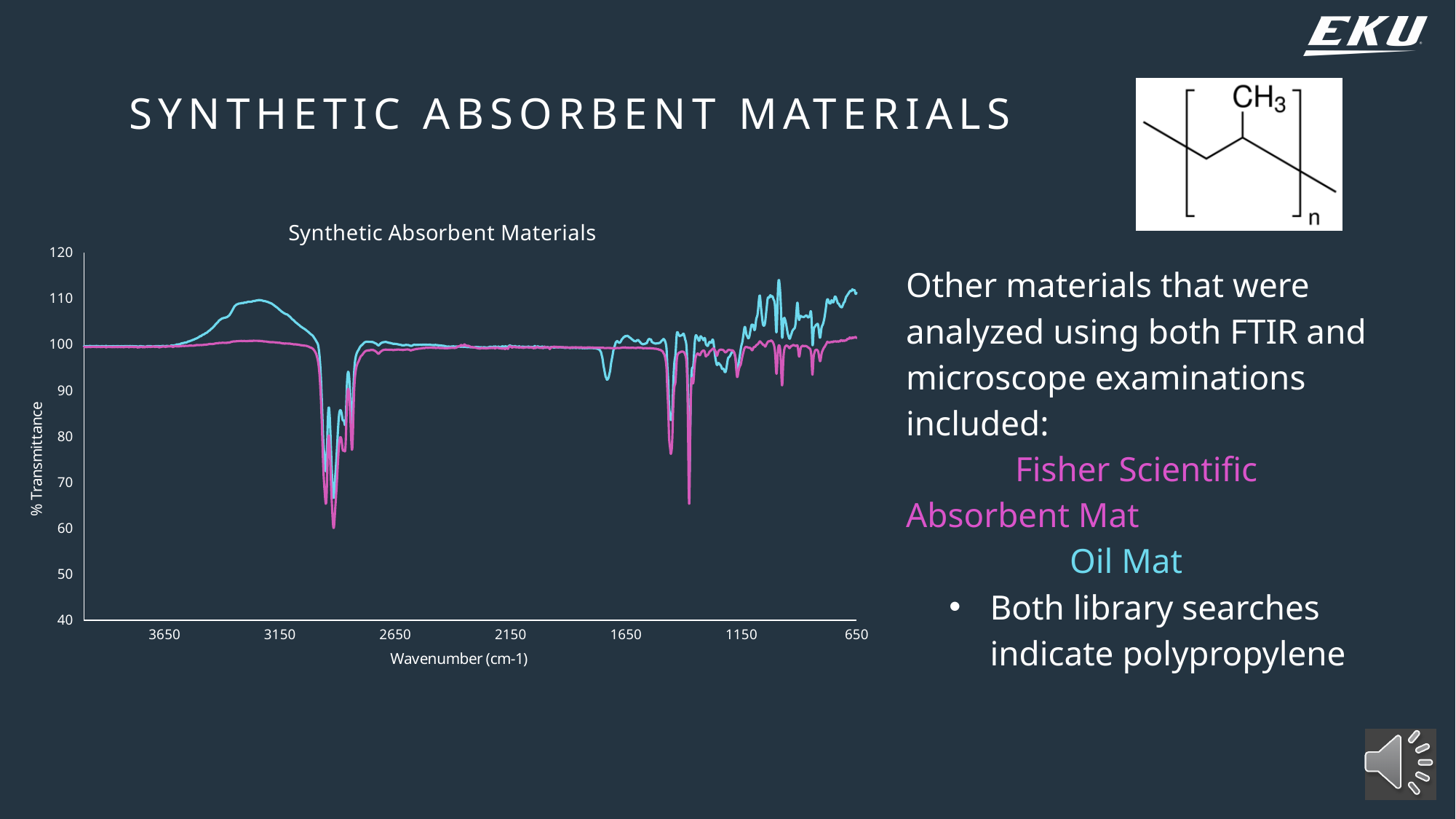
What is the title of the chart? Synthetic Absorbent Materials What kind of chart is shown on the slide? line chart What is the label on the y axis of the chart? % Transmittance Which line reaches the lower minimum near 2900 cm-1, the pink line or the blue line? the pink line How many lines (series) are plotted on the chart? 2 Which line is higher around 3250 cm-1, the pink line or the blue line? the blue line